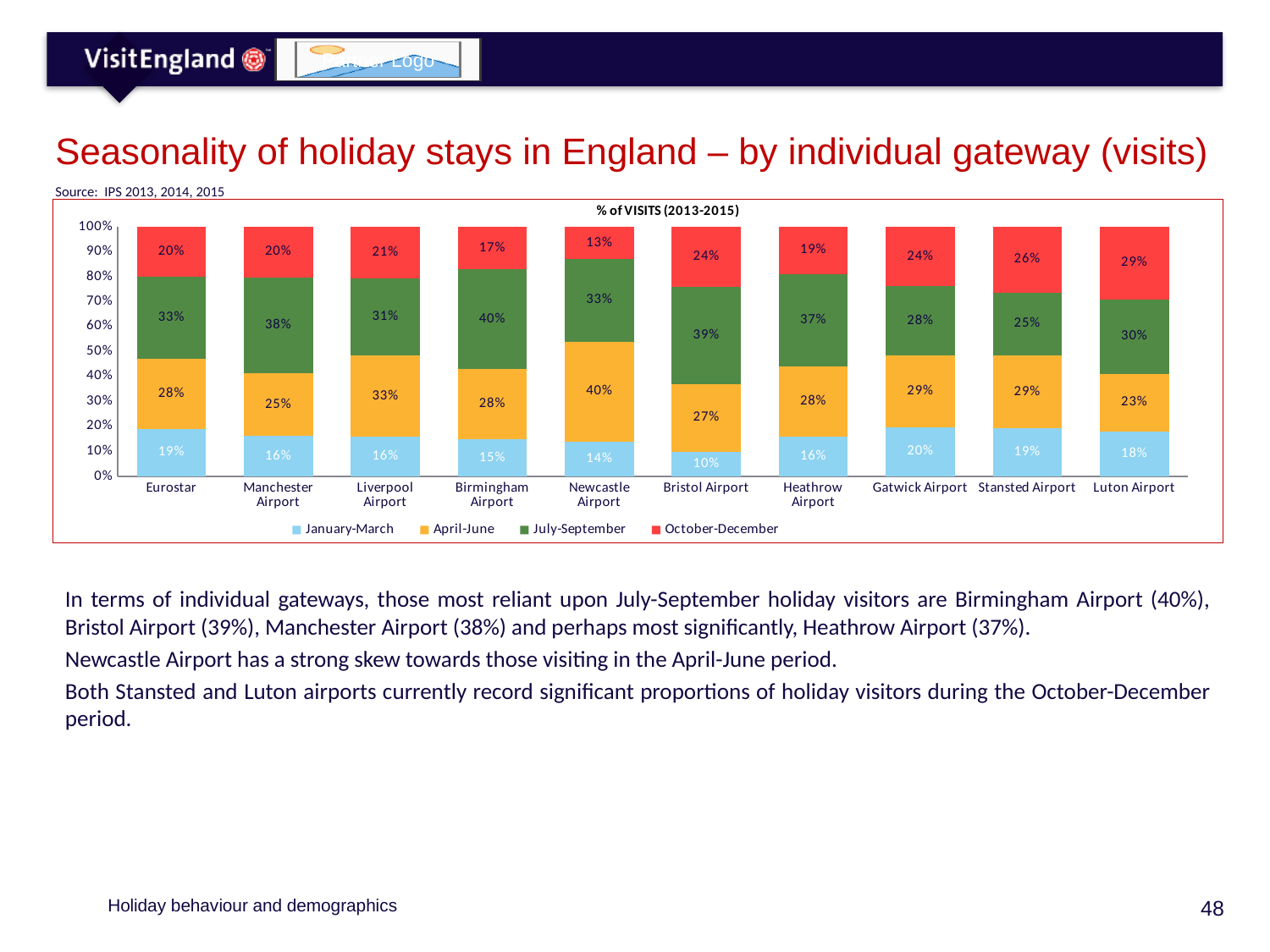
How many series does the legend list? 4 Which gateway has the highest July-September share of visits? Birmingham Airport What percentage of visits at Birmingham Airport fall in July-September? 40% What is the January-March value for Bristol Airport? 10% What is the April-June share of visits for Newcastle Airport? 40% Which has the larger April-June share: Newcastle Airport or Bristol Airport? Newcastle Airport What is the difference between the July-September and October-December shares for Birmingham Airport? 23 percentage points How many gateways are shown on the x axis? 10 Which gateway has the highest October-December share of visits? Luton Airport What is the October-December share for Luton Airport? 29% Which gateway has the lowest January-March share of visits? Bristol Airport What kind of chart is shown on the slide? Stacked bar chart